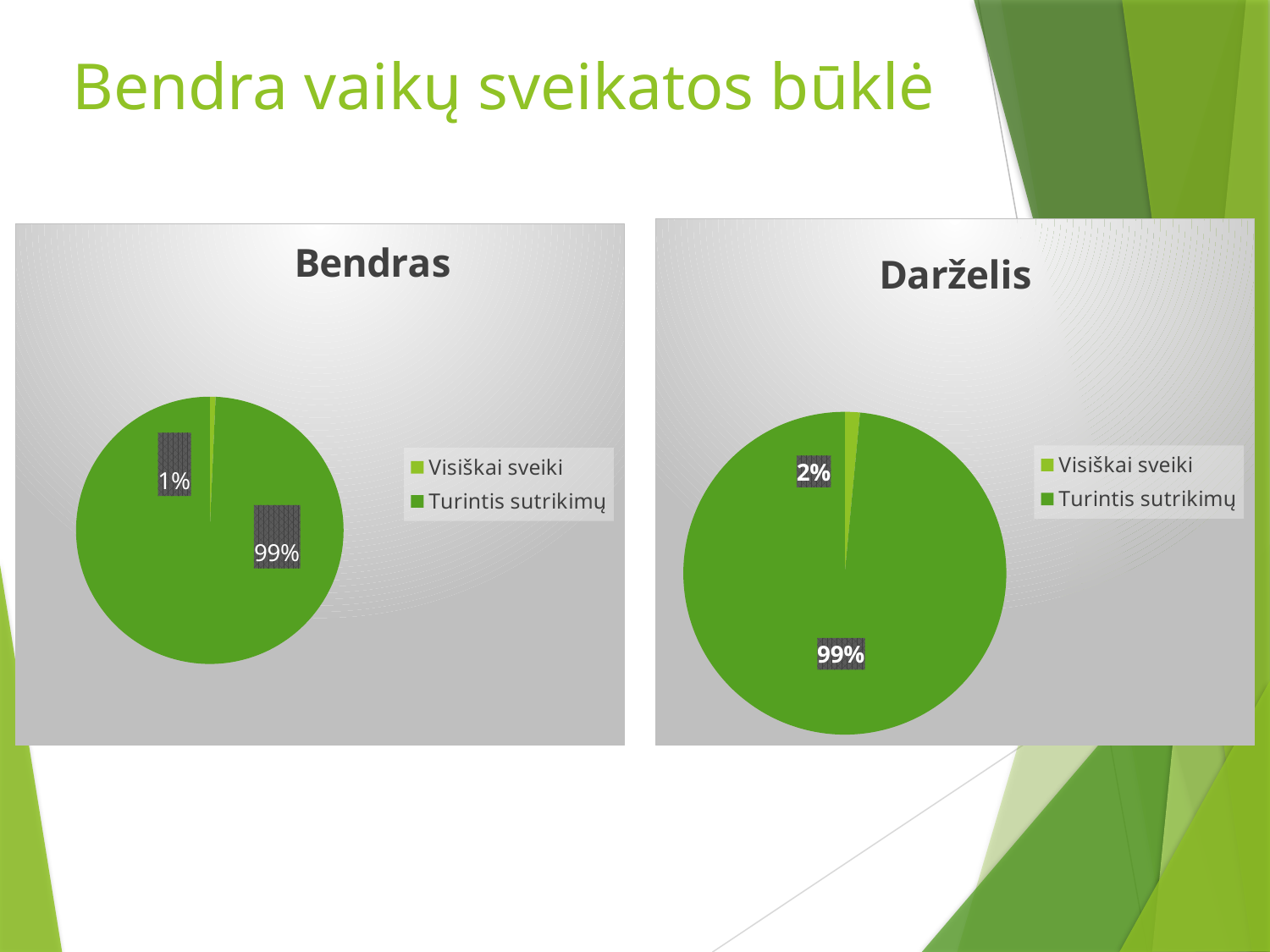
What kind of chart is the Bendras chart? Pie chart In the Bendras chart, what share of the pie is Turintis sutrikimų? 99% What is the title of the chart on the right side of the slide? Darželis How many slices does the Darželis pie chart have? 2 In the Darželis chart, which category has the smallest slice? Visiškai sveiki In the Darželis chart, what share of the pie is Turintis sutrikimų? 99% In the Darželis chart, what share of the pie is Visiškai sveiki? 2% In the Bendras chart, which is larger, Visiškai sveiki or Turintis sutrikimų? Turintis sutrikimų How many entries does the legend of the Bendras chart list? 2 In the Bendras chart, which category has the largest slice? Turintis sutrikimų In the Darželis chart, what is the difference between the Turintis sutrikimų and Visiškai sveiki shares? 97%